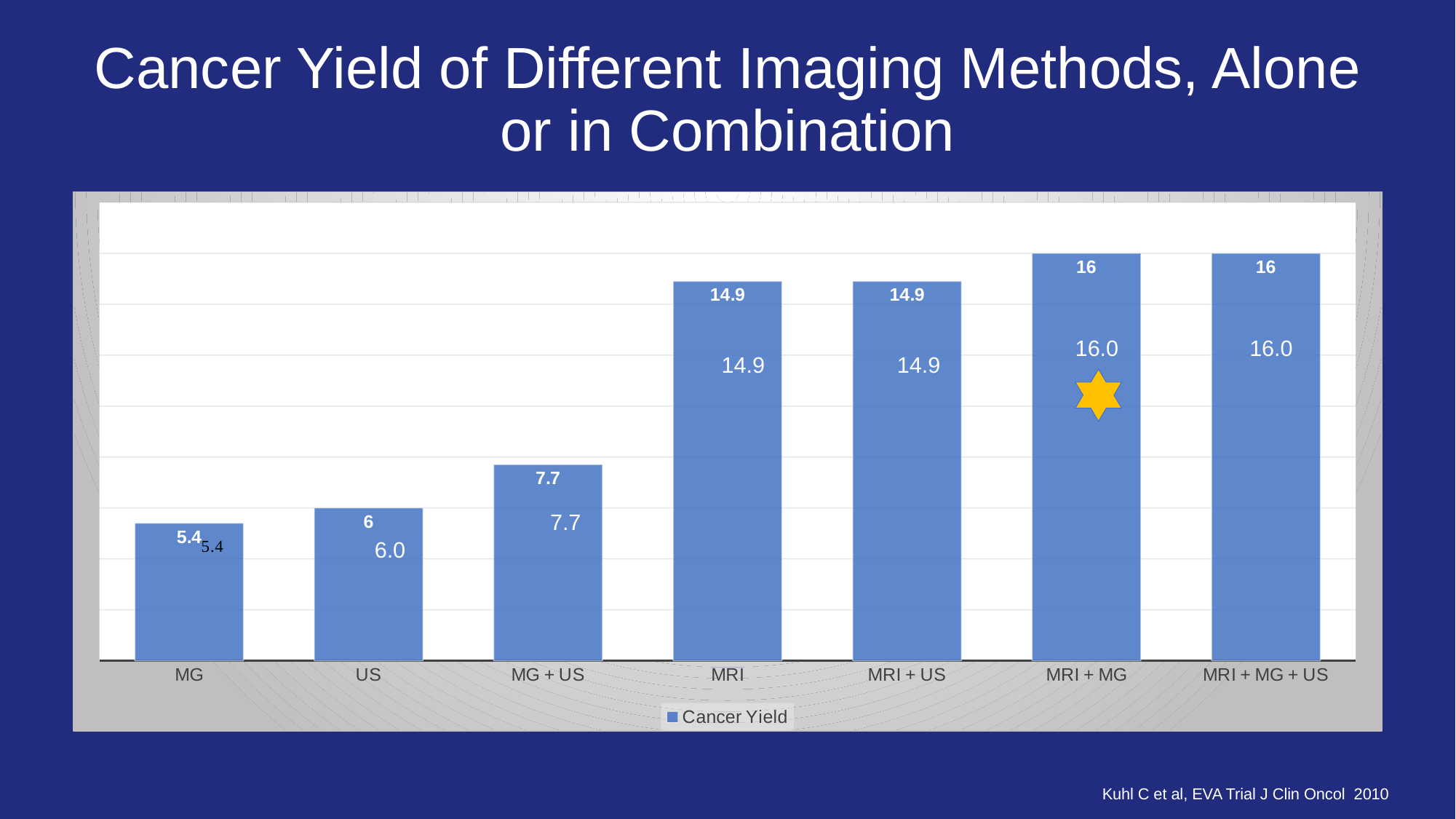
Which category has the lowest cancer yield? MG What is the difference in cancer yield between MRI + MG and MRI? 1.1 What is the cancer yield value for MRI + MG + US? 16 Which has a higher cancer yield, MRI or MG + US? MRI What is the cancer yield value for US? 6 How many series does the legend list? 1 What is the cancer yield value for MG + US? 7.7 What is the difference in cancer yield between MG + US and MG? 2.3 What is the cancer yield value for MRI? 14.9 What is the name of the series shown in the legend? Cancer Yield What kind of chart is shown on the slide? Bar chart How many categories are shown on the x axis? 7